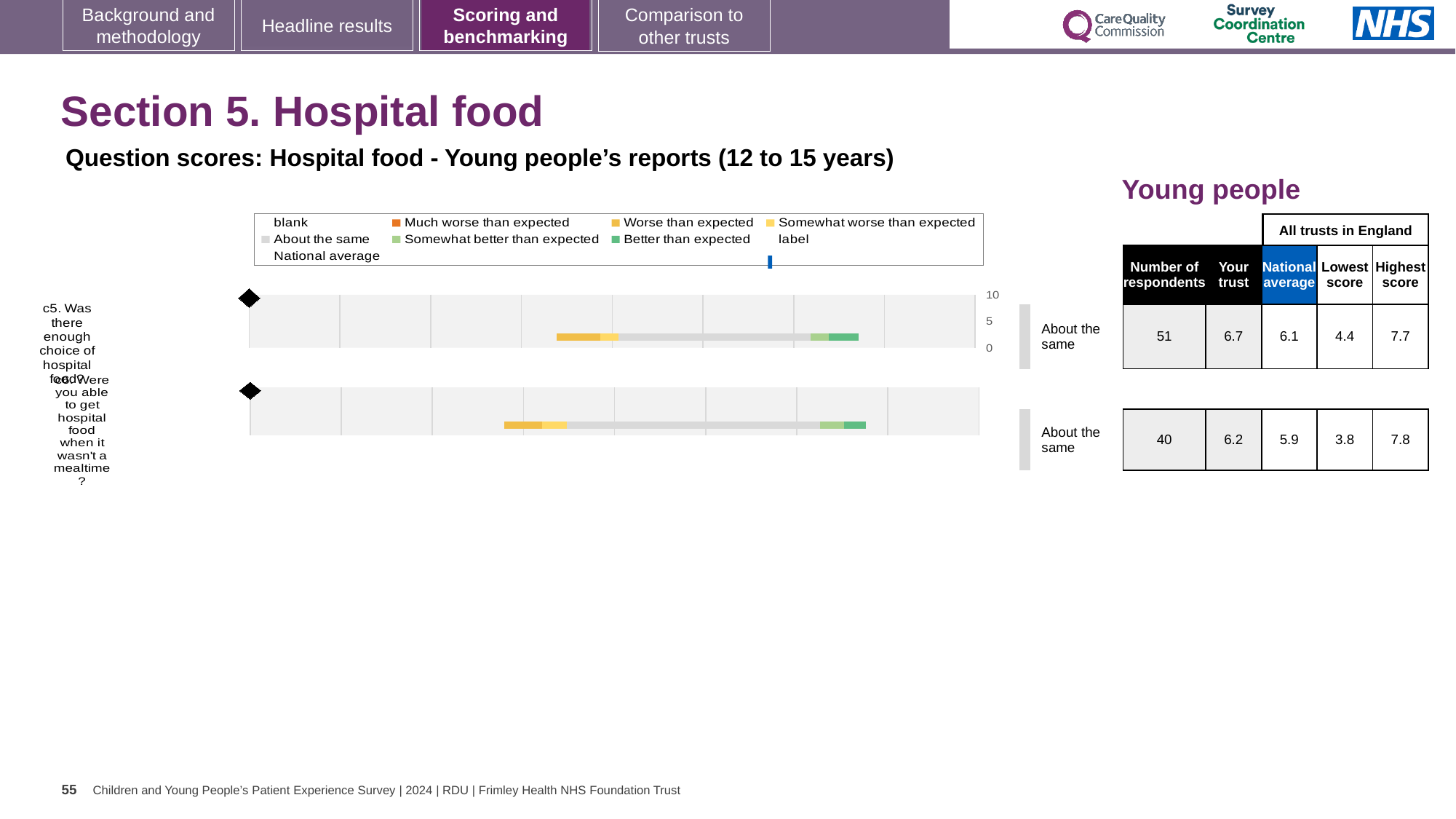
What is the difference between the 'Your trust' score and the national average for question c5? 0.6 How many respondents answered question c5? 51 What is the national average score for question c6 (Were you able to get hospital food when it wasn't a mealtime?)? 5.9 How many questions (bars) are plotted in the hospital food chart? 2 Which question has the higher 'Your trust' score, c5 or c6? c5 What kind of chart is used to show the question scores for hospital food? bar chart Which question has the lower number of respondents? c6 What benchmark category is shown next to the bar for question c6? About the same What is the difference between the highest and lowest scores across all trusts for question c5? 3.3 What is the 'Your trust' score for question c5 (Was there enough choice of hospital food?)? 6.7 What is the maximum value shown on the chart's score axis? 10 What is the highest score across all trusts in England for question c6? 7.8